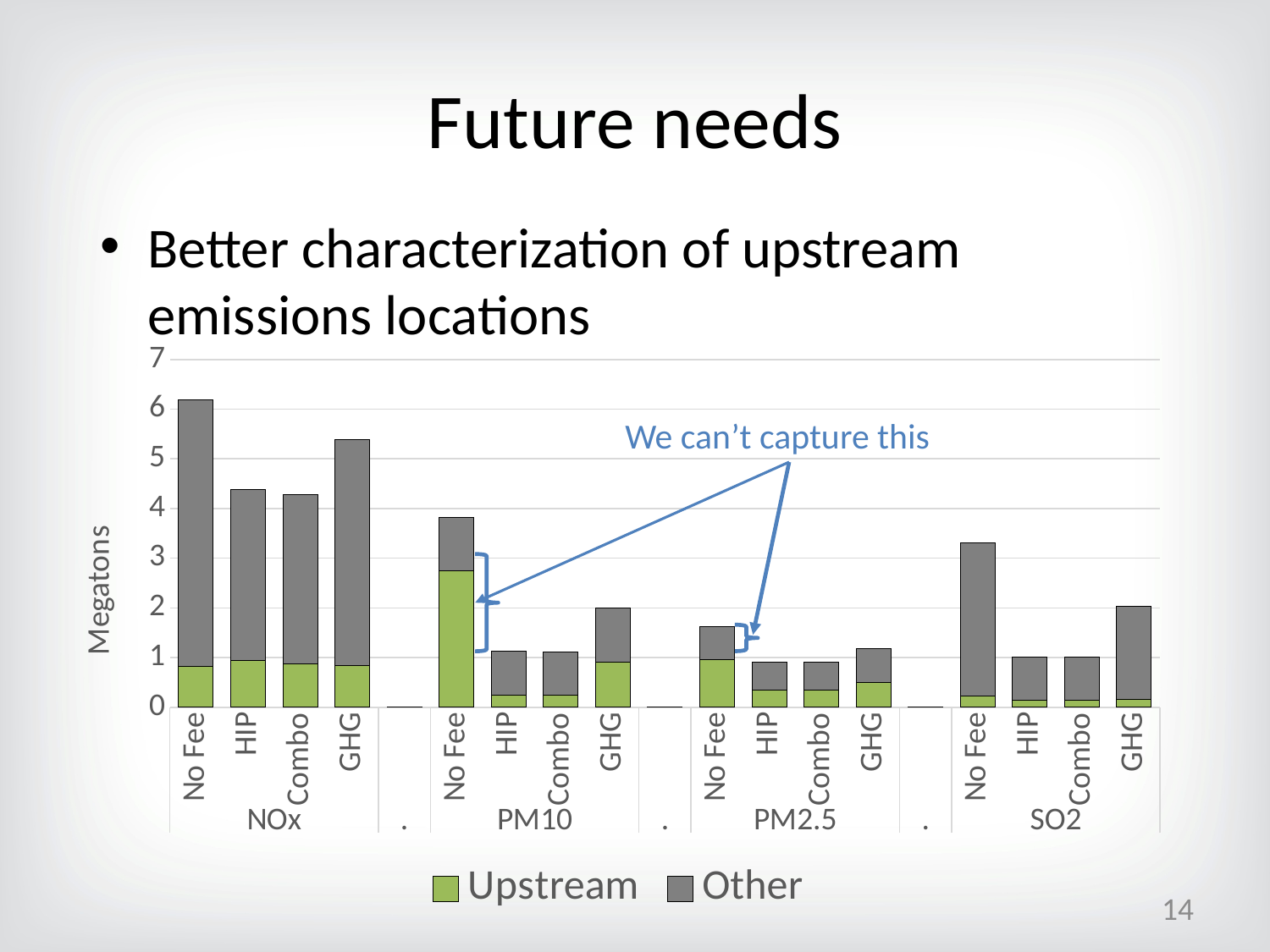
How many series does the legend list? 2 What kind of chart is shown on the slide? stacked bar chart Which is larger, the No Fee bar under PM10 or the No Fee bar under SO2? No Fee under PM10 Is the total for No Fee under SO2 greater or less than 3? greater What is the label on the vertical axis? Megatons How many bars are plotted within each pollutant group? 4 Which bar is the tallest in the whole chart? No Fee under NOx What are the two series named in the legend? Upstream and Other How many pollutant groups are shown along the x axis? 4 Is the total for No Fee under NOx greater or less than 5? greater Within the SO2 group, which scenario has the tallest bar? No Fee